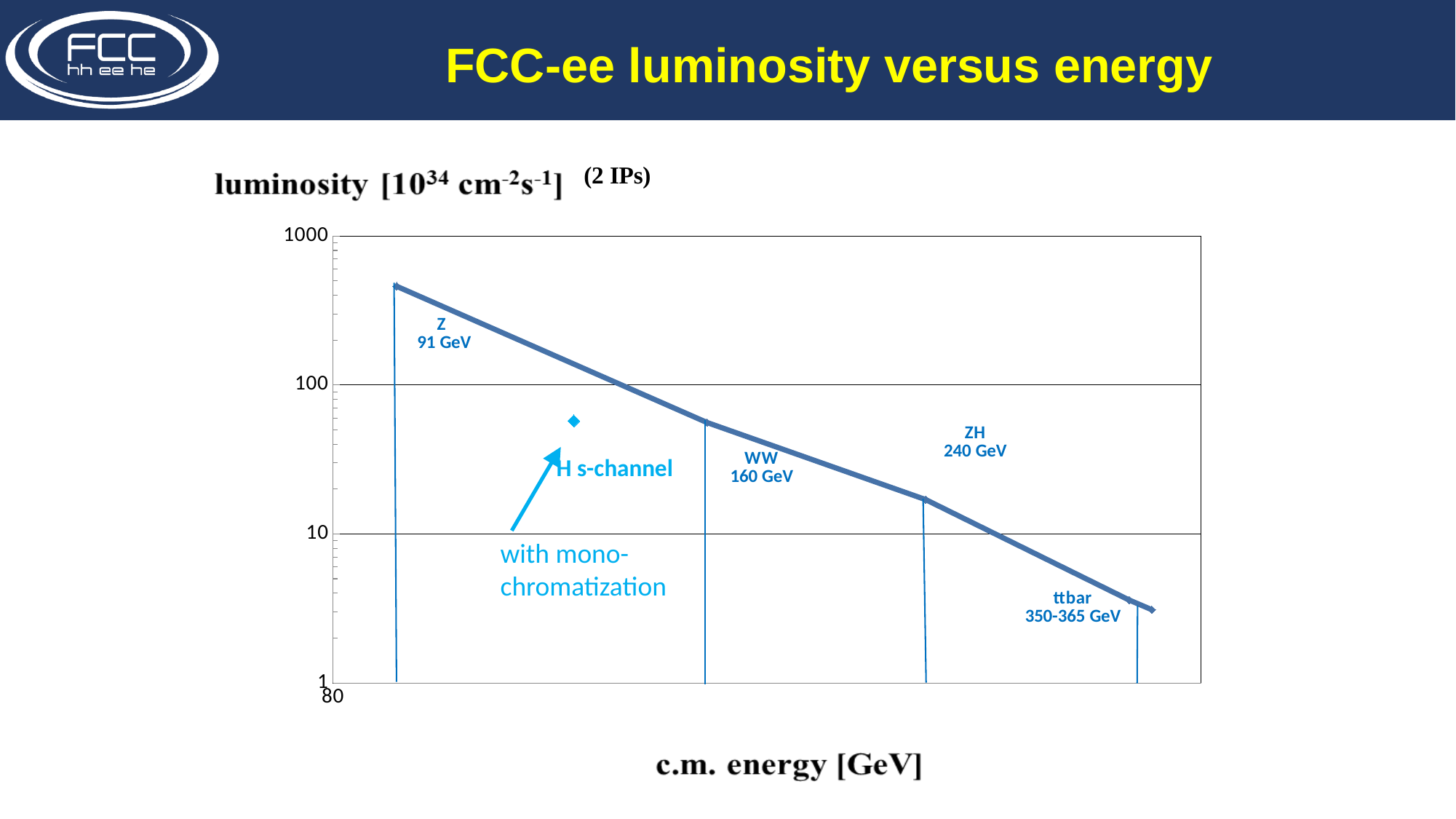
Which labelled operating point has the highest luminosity? Z (91 GeV) Is the luminosity at the ZH (240 GeV) point greater or less than 10? greater Is the luminosity at the WW (160 GeV) point greater or less than 100? less What is the label of the x axis of the chart? c.m. energy [GeV] Is the luminosity at the Z (91 GeV) point greater or less than 100? greater How many labelled operating points lie on the main luminosity curve? 4 Which labelled operating point has the lowest luminosity? ttbar (350-365 GeV) What kind of chart is shown on the slide? line chart Which has the higher luminosity, the WW (160 GeV) point or the ZH (240 GeV) point? WW (160 GeV) Does the luminosity rise or fall as the c.m. energy increases along the x axis? fall